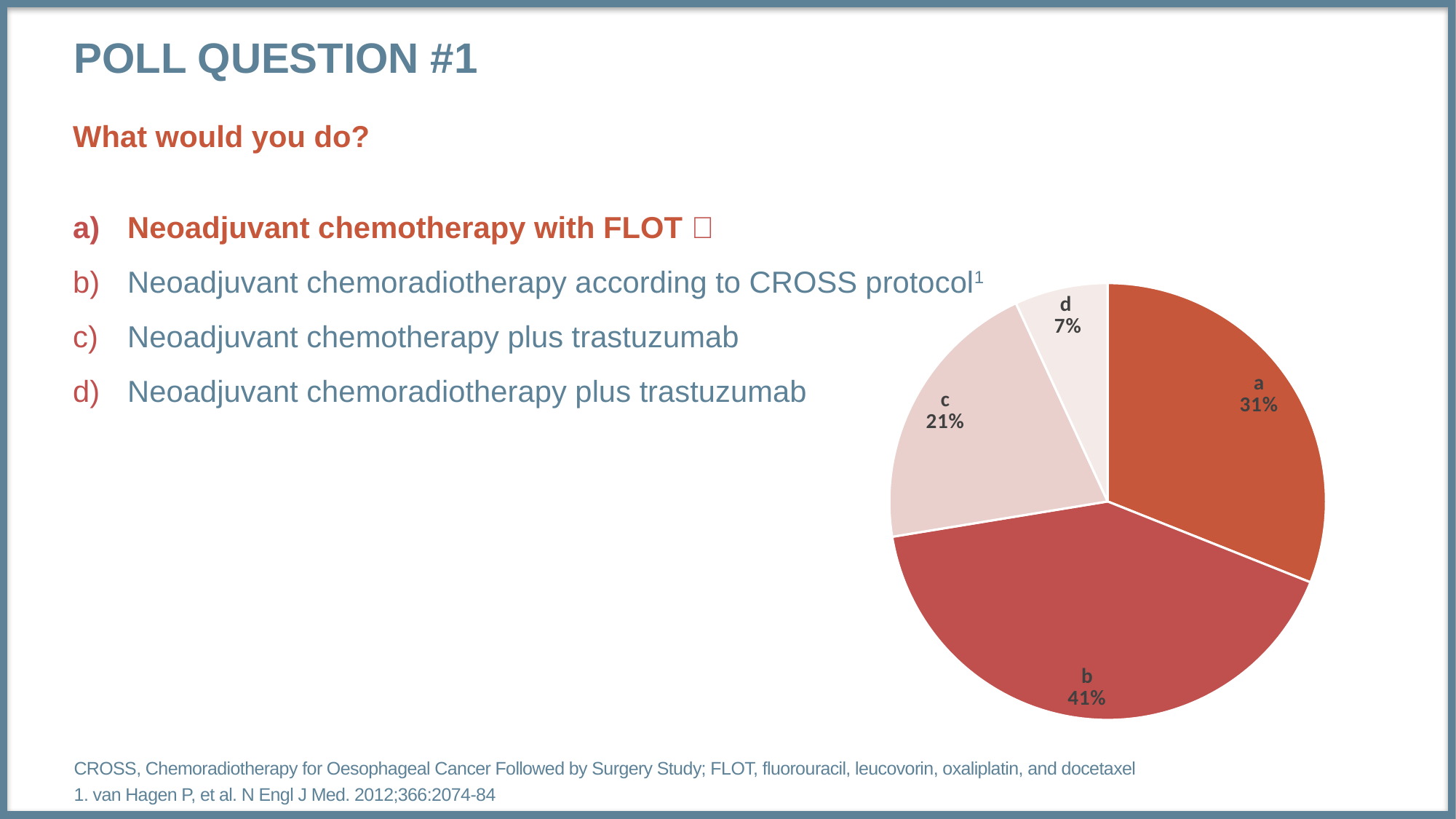
What percentage of the pie is slice c? 21% What kind of chart is shown on the slide? pie chart What percentage of the pie is slice d? 7% Which slice of the pie chart is the largest? b What percentage of the pie is slice a? 31% Which slice of the pie chart is the smallest? d What is the difference in percentage points between slice b and slice a? 10 What percentage of the pie is slice b? 41% How many slices does the pie chart have? 4 What is the combined share of slices c and d? 28% Which is larger, slice a or slice c? a